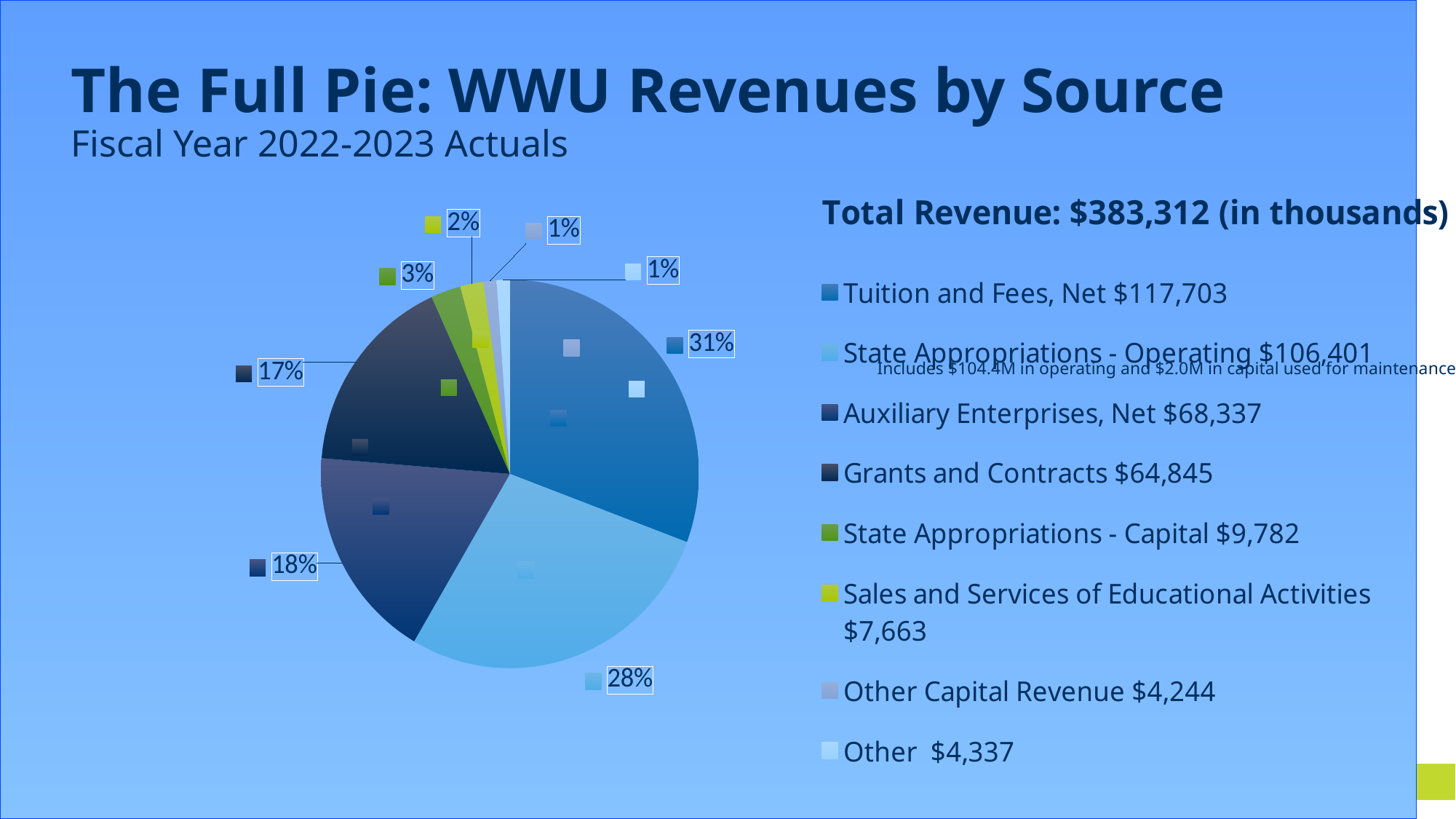
What kind of chart is shown on the slide? pie chart Which is larger, the share for Auxiliary Enterprises, Net or the share for Grants and Contracts? Auxiliary Enterprises, Net Which revenue source has the largest share of the pie? Tuition and Fees, Net What is the difference in percentage points between the Tuition and Fees, Net share and the State Appropriations - Operating share? 3 What share of the pie is State Appropriations - Capital? 3% What share of the pie is Auxiliary Enterprises, Net? 18% How many slices does the pie chart have? 8 What total revenue is stated on the slide? $383,312 (in thousands) What share of the pie is State Appropriations - Operating? 28% What is the revenue value shown for Other Capital Revenue? $4,244 What is the revenue value shown for Tuition and Fees, Net? $117,703